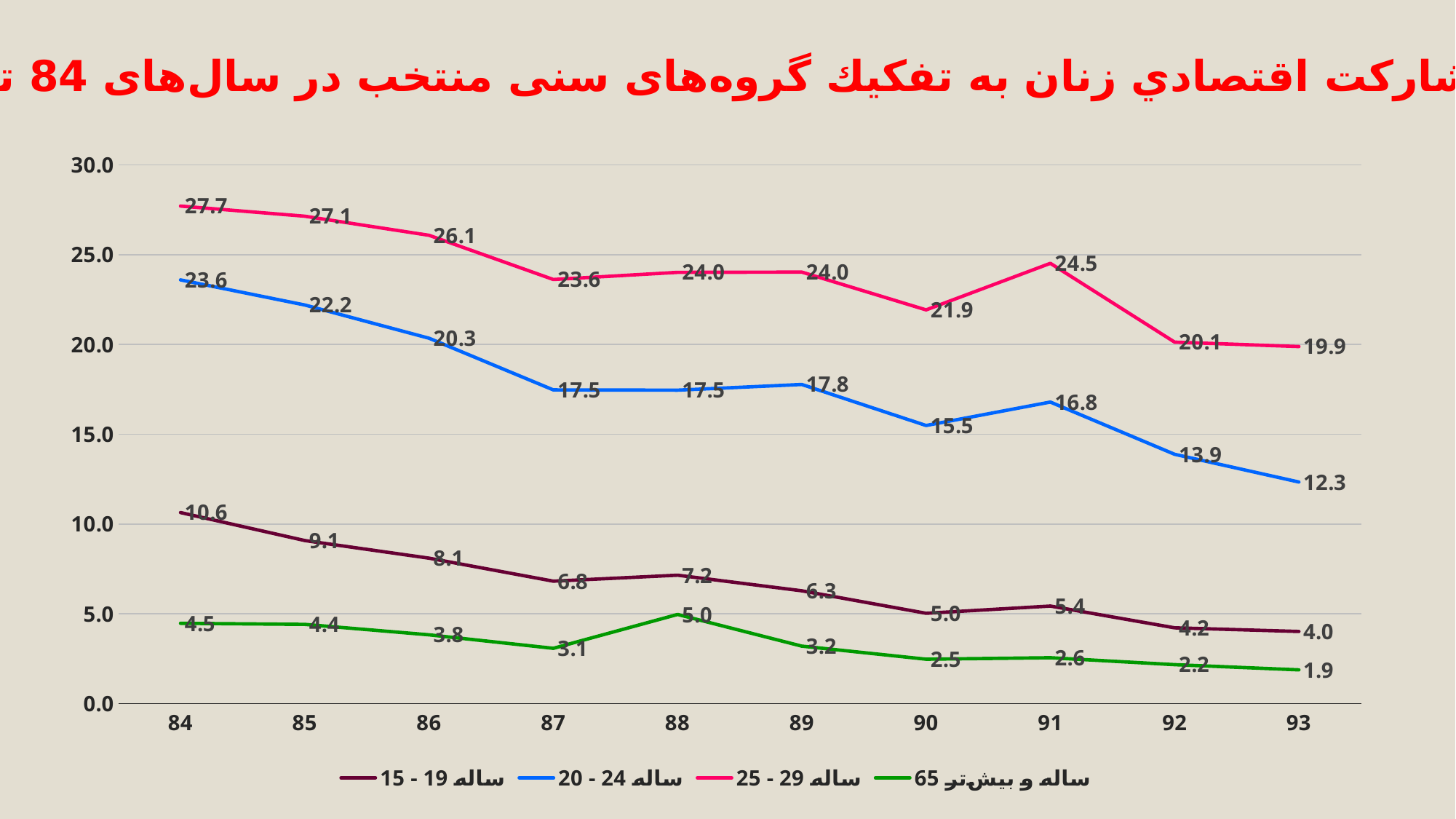
What is the value for the 15 - 19 ساله series in year 88? 7.2 What kind of chart is shown on the slide? Line chart What is the value for the 65 ساله و بیش‌تر series in year 90? 2.5 What is the value for the 25 - 29 ساله series in year 84? 27.7 How many years are shown on the x axis? 10 In which year does the 65 ساله و بیش‌تر series reach its lowest value? 93 How many series does the legend list? 4 Which is larger: the 25 - 29 ساله value in year 91 or in year 90? Year 91 (24.5) Does the 15 - 19 ساله series generally rise or fall from year 84 to year 93? Fall What is the difference between the 20 - 24 ساله values in year 84 and year 93? 11.3 In which year does the 25 - 29 ساله series reach its highest value? 84 What is the value for the 20 - 24 ساله series in year 93? 12.3